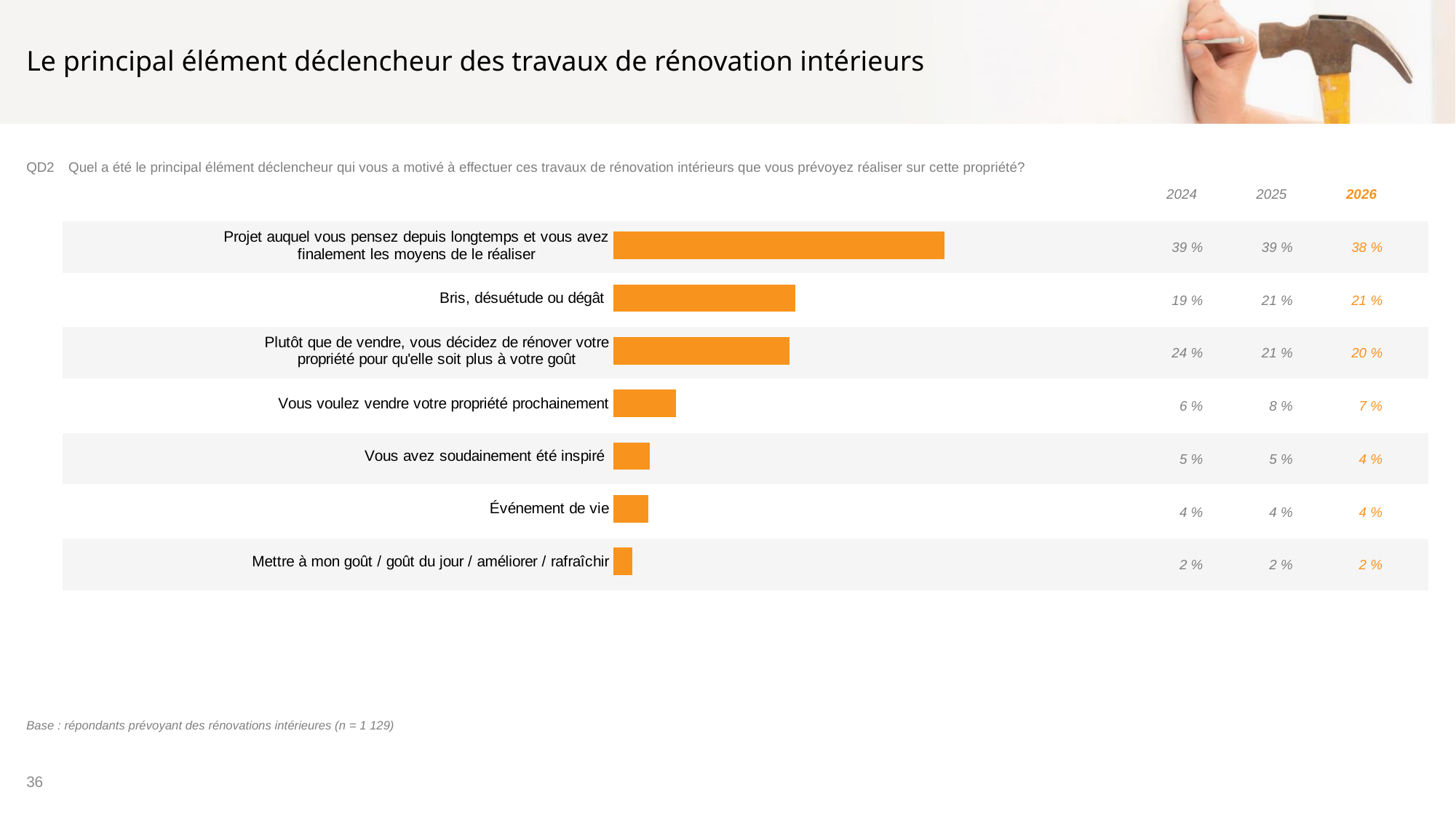
How many years of data are shown in the table next to the chart? 3 How did the value for "Vous avez soudainement été inspiré" change from 2025 to 2026? It fell from 5 % to 4 % What kind of chart is shown on the slide? Bar chart Which year's column is highlighted in orange in the table? 2026 Which category has the highest value in 2026? Projet auquel vous pensez depuis longtemps et vous avez finalement les moyens de le réaliser What is the 2024 value for "Plutôt que de vendre, vous décidez de rénover votre propriété pour qu'elle soit plus à votre goût"? 24 % What is the 2026 value for "Bris, désuétude ou dégât"? 21 % Which is larger in 2024: "Bris, désuétude ou dégât" or "Plutôt que de vendre, vous décidez de rénover votre propriété pour qu'elle soit plus à votre goût"? Plutôt que de vendre, vous décidez de rénover votre propriété pour qu'elle soit plus à votre goût Which category has the lowest value in 2026? Mettre à mon goût / goût du jour / améliorer / rafraîchir How many categories are shown in the chart? 7 What is the difference between the 2026 values for "Projet auquel vous pensez depuis longtemps et vous avez finalement les moyens de le réaliser" and "Bris, désuétude ou dégât"? 17 % What is the 2025 value for "Vous voulez vendre votre propriété prochainement"? 8 %